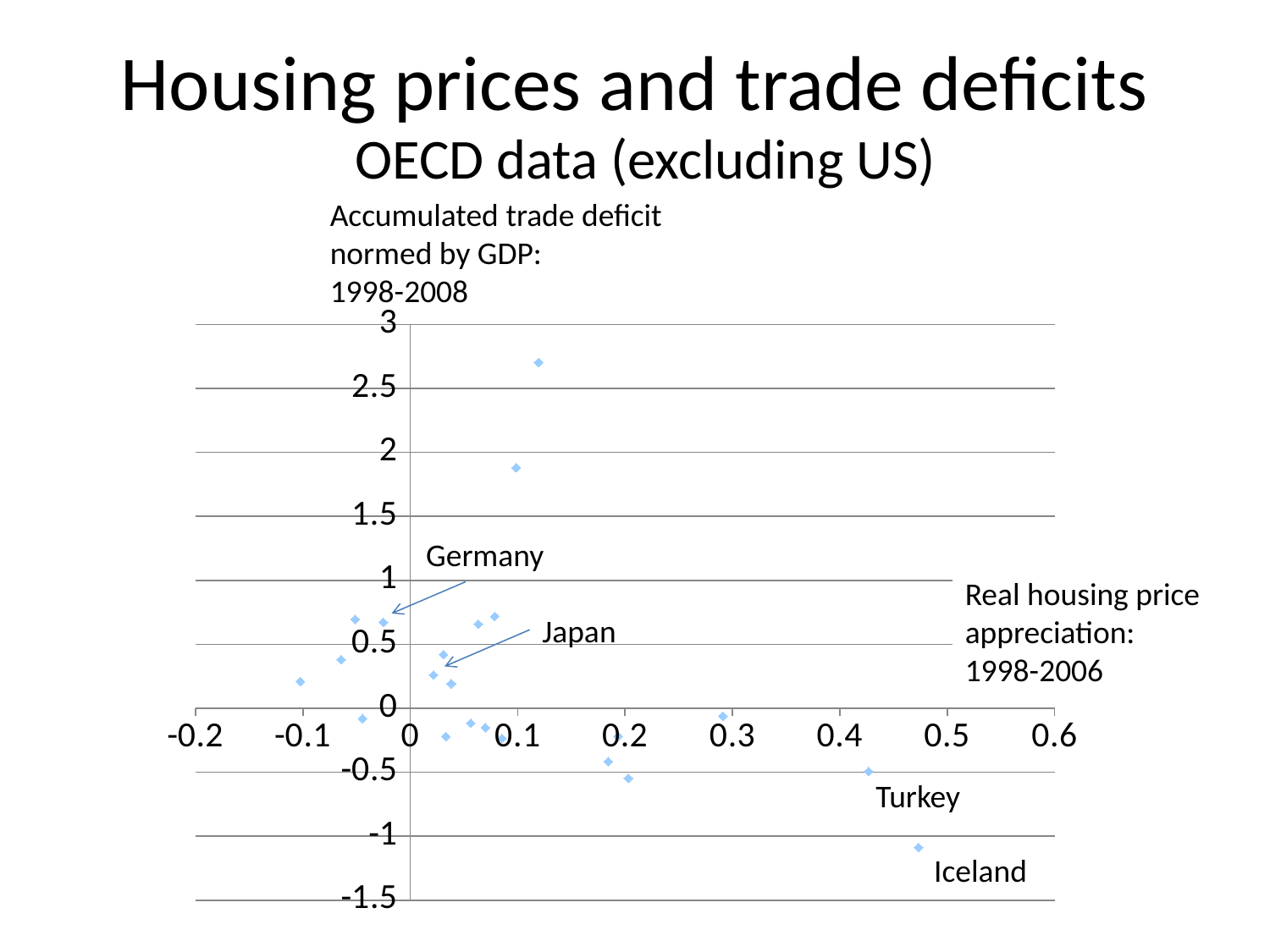
What is the title of the chart on the slide? Housing prices and trade deficits OECD data (excluding US) Is the accumulated trade deficit value for Japan greater or less than 0.5? less What kind of chart is shown on the slide? scatter chart What does the horizontal axis of the chart represent? Real housing price appreciation: 1998-2006 Is the accumulated trade deficit value for Turkey greater or less than 0? less Which has the higher real housing price appreciation, Turkey or Germany? Turkey Which has the higher accumulated trade deficit normed by GDP, Germany or Japan? Germany Is the real housing price appreciation for Iceland greater or less than 0.4? greater Which labelled country has the highest accumulated trade deficit normed by GDP? Germany Which labelled country has the lowest accumulated trade deficit normed by GDP? Iceland